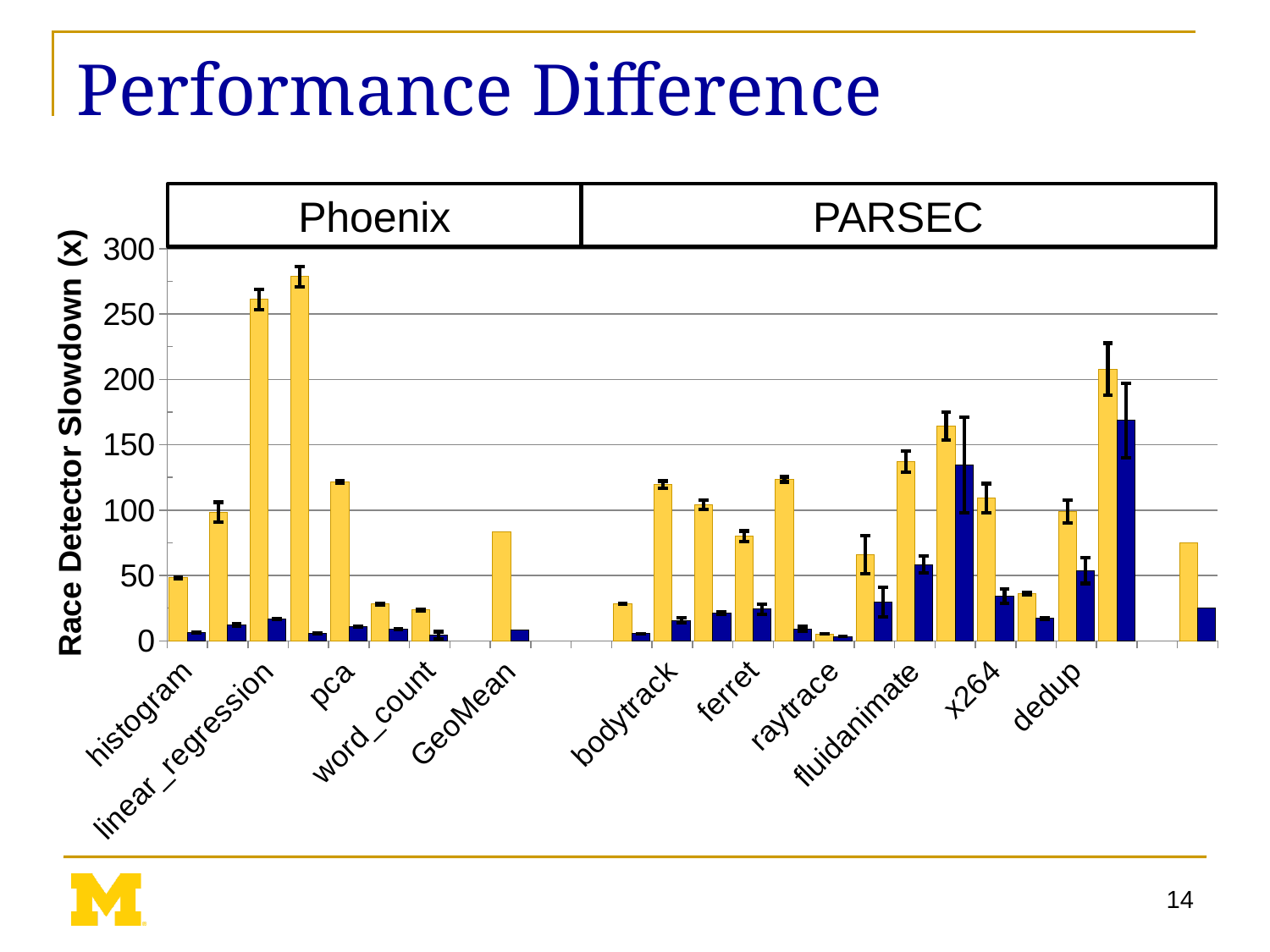
Is the blue bar for histogram greater or less than 50? less What kind of chart is shown on the slide? bar chart What is the highest value shown on the vertical axis? 300 Is the yellow bar for histogram greater or less than 100? less Is the yellow bar for GeoMean in the Phoenix group greater or less than 50? greater For histogram, which bar is taller, the yellow one or the blue one? the yellow one What are the two benchmark suite groups labelled above the chart? Phoenix and PARSEC What is the label of the vertical axis? Race Detector Slowdown (x)